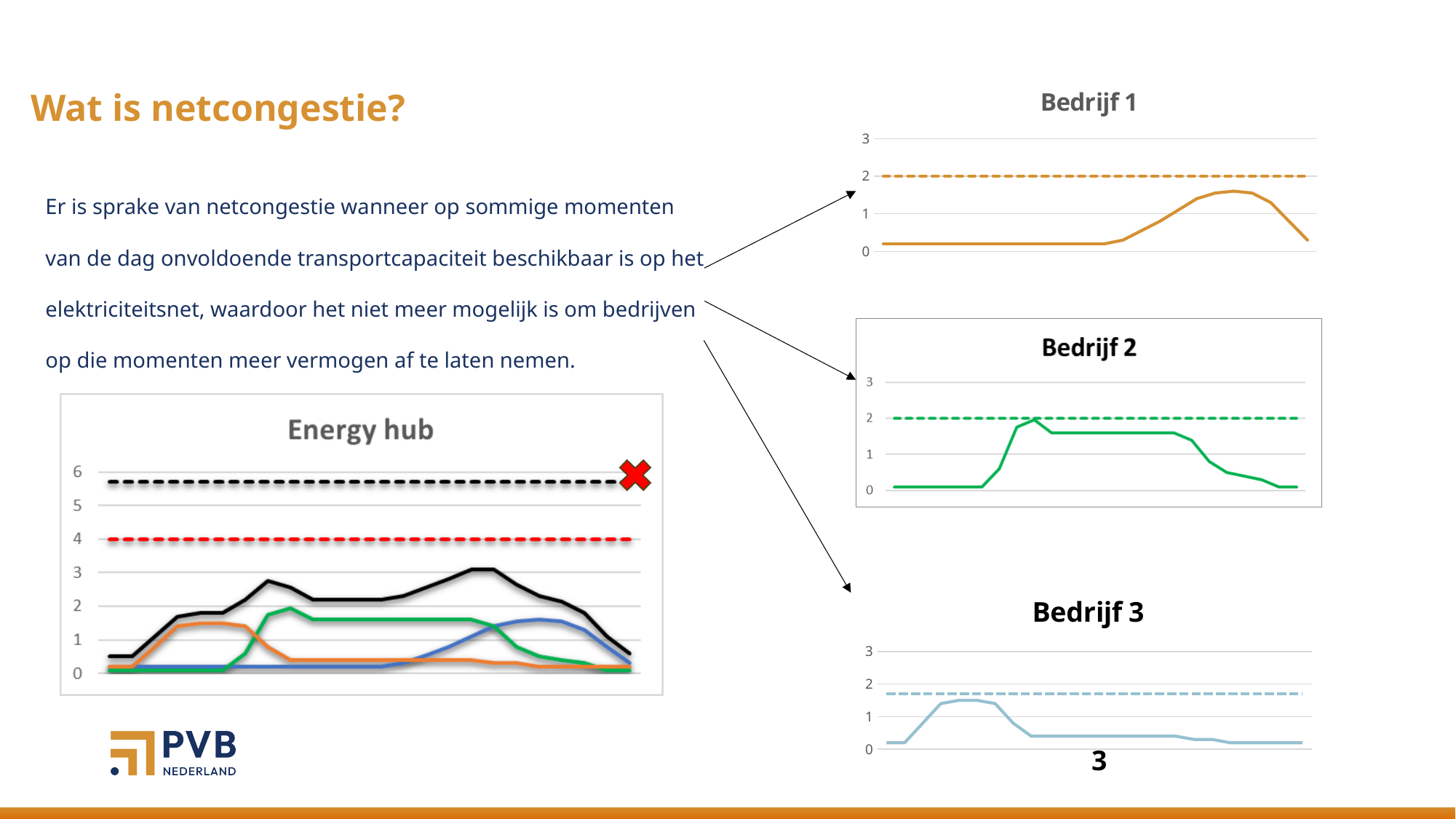
In the 'Bedrijf 3' chart, is the peak value of the solid blue line greater or less than 2? less What kind of chart is the 'Energy hub' chart? line chart In the 'Energy hub' chart, is the peak value of the solid black line greater or less than 2? greater In the 'Bedrijf 2' chart, at what value does the dashed horizontal line sit? 2 What is the highest value shown on the y axis of the 'Energy hub' chart? 6 In the 'Bedrijf 1' chart, is the peak value of the solid orange line greater or less than 2? less What kind of chart is the 'Bedrijf 1' chart? line chart What is the highest value shown on the y axis of the 'Bedrijf 2' chart? 3 In the 'Bedrijf 1' chart, at what value does the dashed horizontal line sit? 2 In the 'Energy hub' chart, at what value does the red dashed horizontal line sit? 4